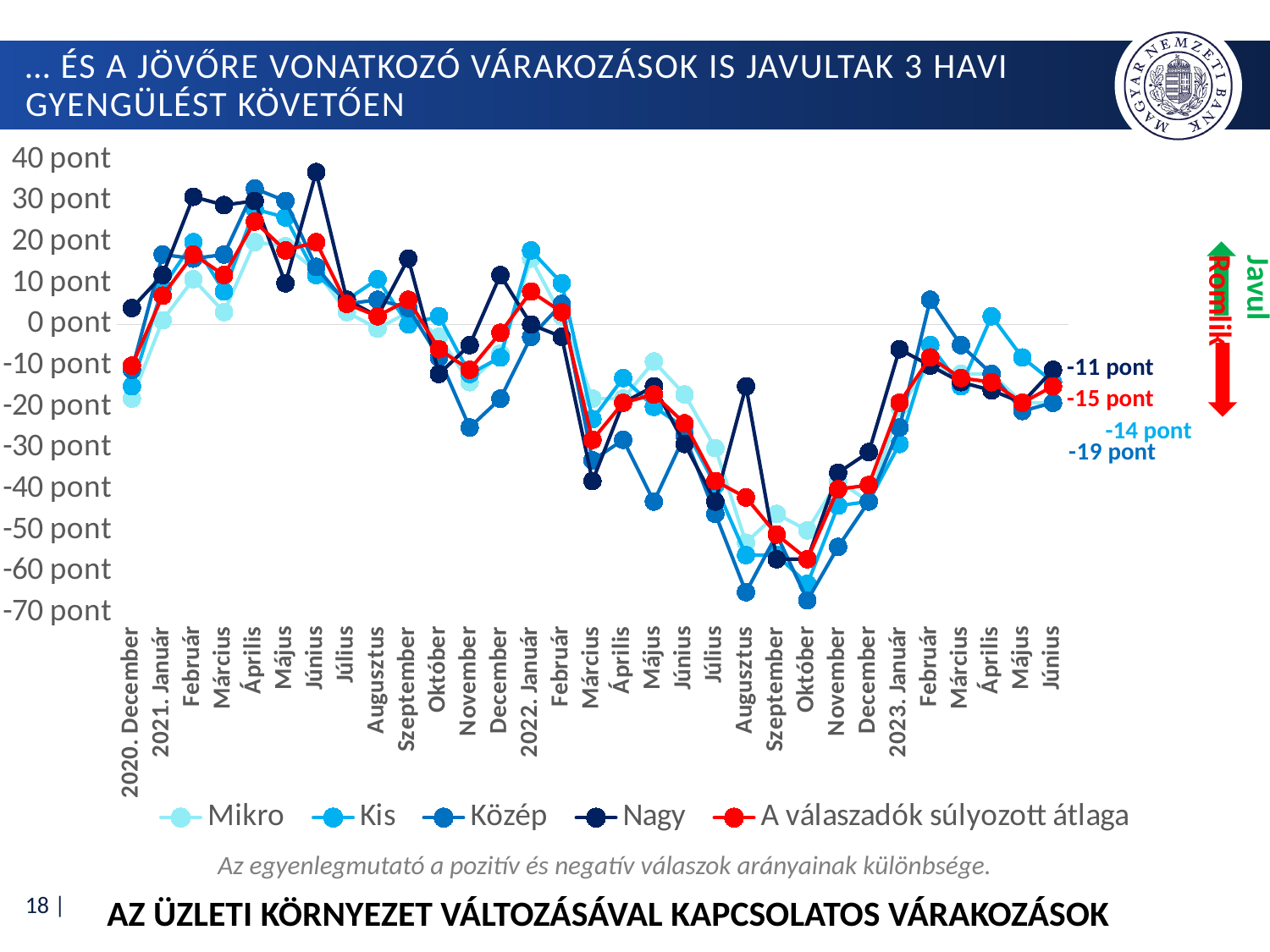
What is the value of 'A válaszadók súlyozott átlaga' for 2023 Június? -15 pont How many months are shown on the x axis? 31 How many series does the legend list? 5 Is the value of 'A válaszadók súlyozott átlaga' for 2022 Október greater or less than -50 pont? less What kind of chart is shown on the slide? line chart Is the value of the 'Nagy' series for 2021 Június greater or less than 30 pont? greater What is the difference between the 'Nagy' value and 'A válaszadók súlyozott átlaga' value in 2023 Június? 4 pont In 2023 Június, which is higher: the 'Nagy' series or 'A válaszadók súlyozott átlaga'? Nagy What is the value of the 'Nagy' series for 2023 Június? -11 pont In which month does 'A válaszadók súlyozott átlaga' reach its highest value? 2021 Április In which month does 'A válaszadók súlyozott átlaga' reach its lowest value? 2022 Október Does 'A válaszadók súlyozott átlaga' rise or fall between 2022 Február and 2022 Október? fall